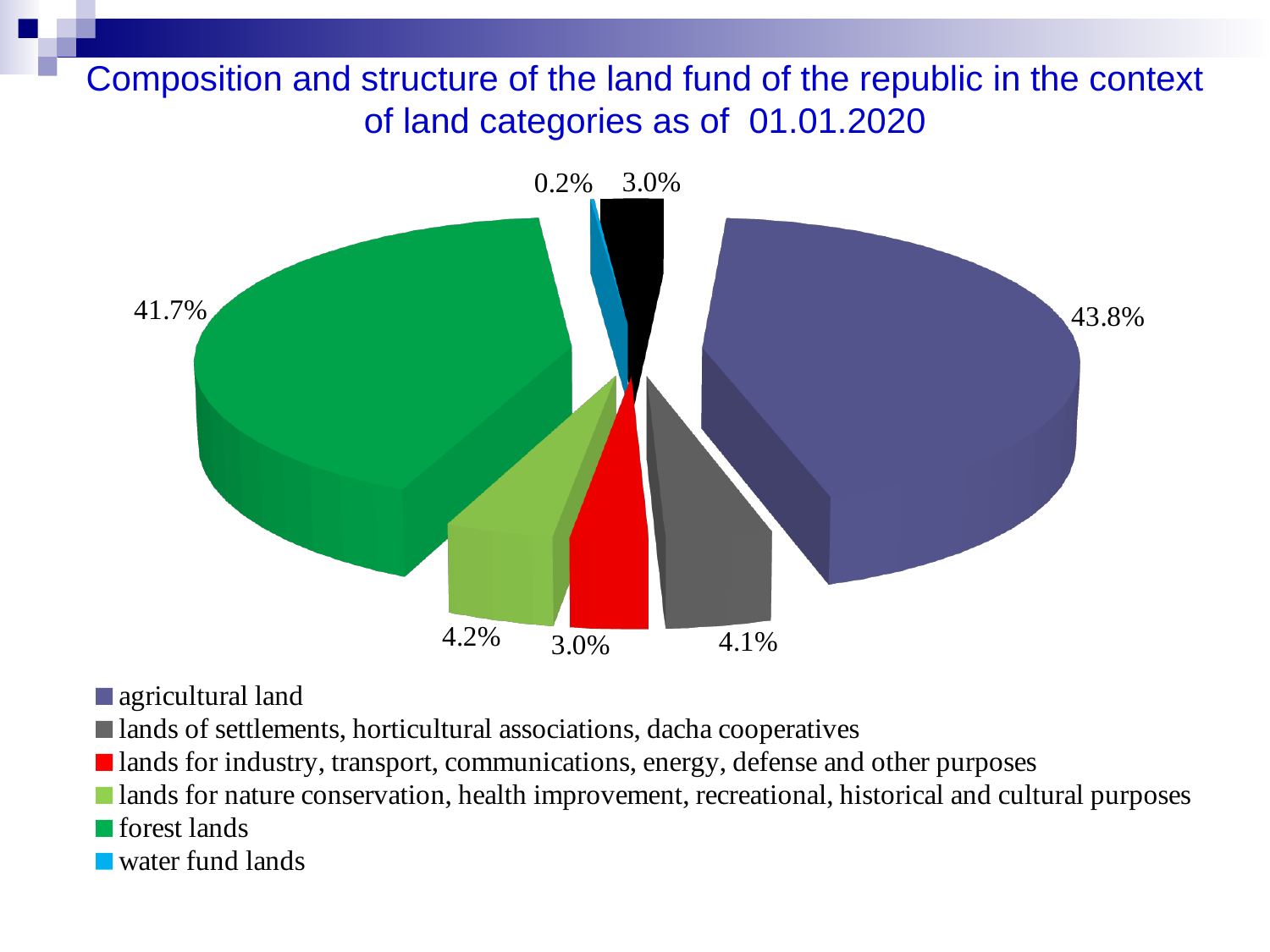
Which land category has the smallest share of the land fund? water fund lands What share is shown for lands for industry, transport, communications, energy, defense and other purposes? 3.0% How many land categories are listed in the legend? 6 What share of the land fund is forest lands? 41.7% What kind of chart is shown on the slide? pie chart What share of the land fund is water fund lands? 0.2% What share of the land fund is agricultural land? 43.8% What share is shown for lands of settlements, horticultural associations, dacha cooperatives? 4.1% By how many percentage points does the share of agricultural land exceed the share of forest lands? 2.1 percentage points Which land category has the largest share of the land fund? agricultural land Which has the larger share: agricultural land or forest lands? agricultural land What share is shown for lands for nature conservation, health improvement, recreational, historical and cultural purposes? 4.2%